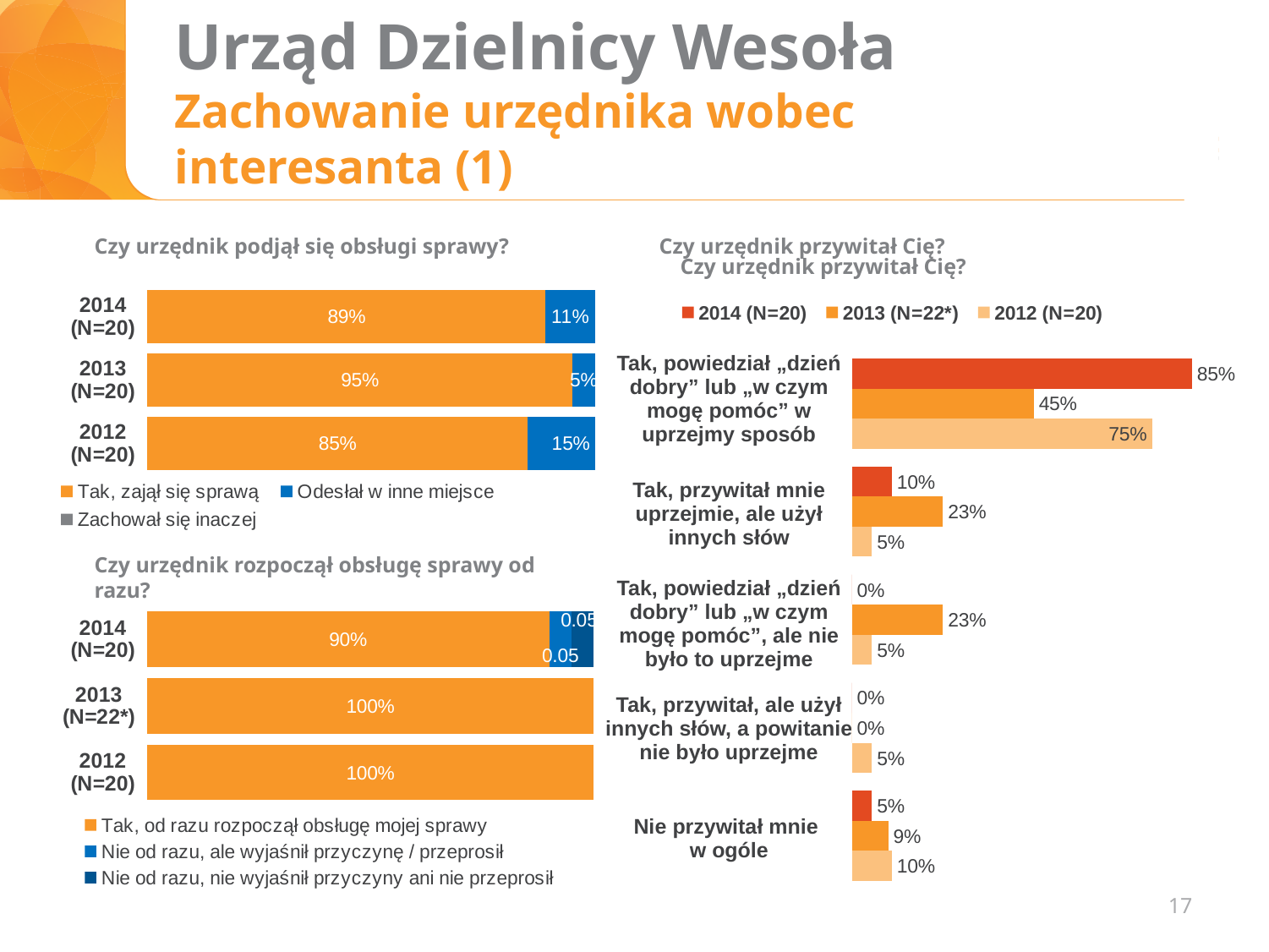
In the chart 'Czy urzędnik przywitał Cię?', how many categories are shown? 5 In the chart 'Czy urzędnik przywitał Cię?', what is the 2013 (N=22*) value for 'Tak, przywitał mnie uprzejmie, ale użył innych słów'? 23% What kind of chart is 'Czy urzędnik przywitał Cię?'? Bar chart In the chart 'Czy urzędnik podjął się obsługi sprawy?', what is the value for 'Tak, zajął się sprawą' in 2014 (N=20)? 89% In the chart 'Czy urzędnik rozpoczął obsługę sprawy od razu?', what is the value for 'Tak, od razu rozpoczął obsługę mojej sprawy' in 2013 (N=22*)? 100% In the chart 'Czy urzędnik podjął się obsługi sprawy?', how many series does the legend list? 3 In the chart 'Czy urzędnik rozpoczął obsługę sprawy od razu?', what is the value for 'Tak, od razu rozpoczął obsługę mojej sprawy' in 2014 (N=20)? 90% In the chart 'Czy urzędnik przywitał Cię?', what is the 2014 (N=20) value for 'Tak, powiedział „dzień dobry” lub „w czym mogę pomóc” w uprzejmy sposób'? 85% In the chart 'Czy urzędnik przywitał Cię?', which is larger for 'Nie przywitał mnie w ogóle': the 2012 (N=20) value or the 2014 (N=20) value? 2012 (N=20) In the chart 'Czy urzędnik przywitał Cię?', what is the difference between the 2014 (N=20) and 2013 (N=22*) values for 'Tak, powiedział „dzień dobry” lub „w czym mogę pomóc” w uprzejmy sposób'? 40% In the chart 'Czy urzędnik podjął się obsługi sprawy?', what is the value for 'Odesłał w inne miejsce' in 2012 (N=20)? 15% In the chart 'Czy urzędnik podjął się obsługi sprawy?', which year has the highest value for 'Tak, zajął się sprawą'? 2013 (N=20)